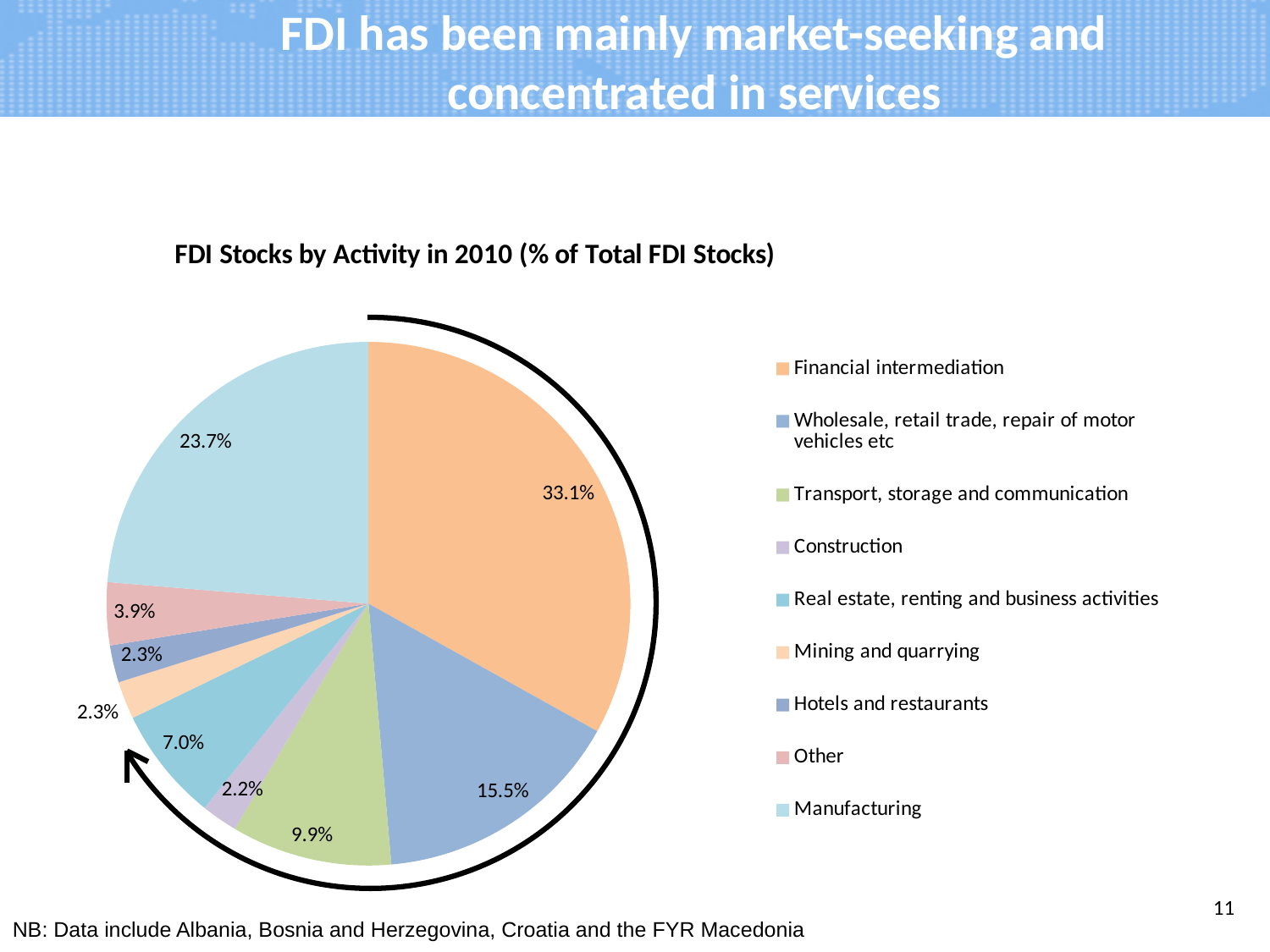
How many activity categories does the legend list? 9 Which activity has the largest share of FDI stocks? Financial intermediation What is the title of the chart? FDI Stocks by Activity in 2010 (% of Total FDI Stocks) What is the value shown for Transport, storage and communication? 9.9% What share of FDI stocks does Financial intermediation account for? 33.1% What type of chart is shown on the slide? pie chart Which has a larger share, Transport, storage and communication or Real estate, renting and business activities? Transport, storage and communication What is the value shown for Wholesale, retail trade, repair of motor vehicles etc? 15.5% What is the value shown for Manufacturing? 23.7% What is the value shown for Other? 3.9% What is the difference between the shares of Financial intermediation and Manufacturing? 9.4% What is the value shown for Real estate, renting and business activities? 7.0%